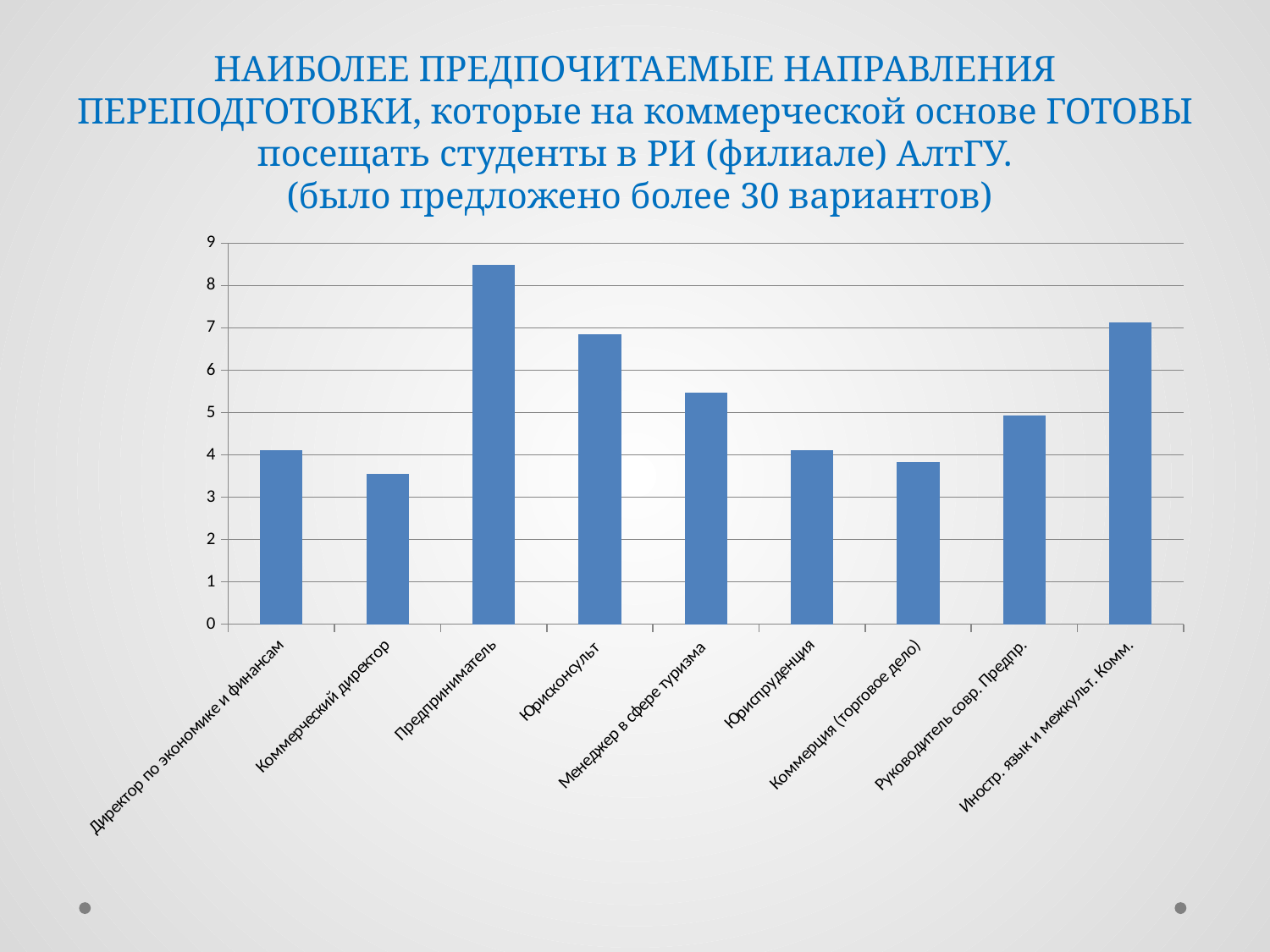
Is the value for Менеджер в сфере туризма greater or less than 5? greater Which has a larger value: Иностр. язык и межкульт. Комм. or Руководитель совр. Предпр.? Иностр. язык и межкульт. Комм. Which has a larger value: Юрисконсульт or Менеджер в сфере туризма? Юрисконсульт Which category has the highest value in the chart? Предприниматель How many categories (bars) are shown in the chart? 9 What kind of chart is shown on the slide? Bar chart Is the value for Юрисконсульт greater or less than 7? less Is the value for Юриспруденция greater or less than 5? less What is the maximum value shown on the vertical axis of the chart? 9 Which has a larger value: Предприниматель or Иностр. язык и межкульт. Комм.? Предприниматель